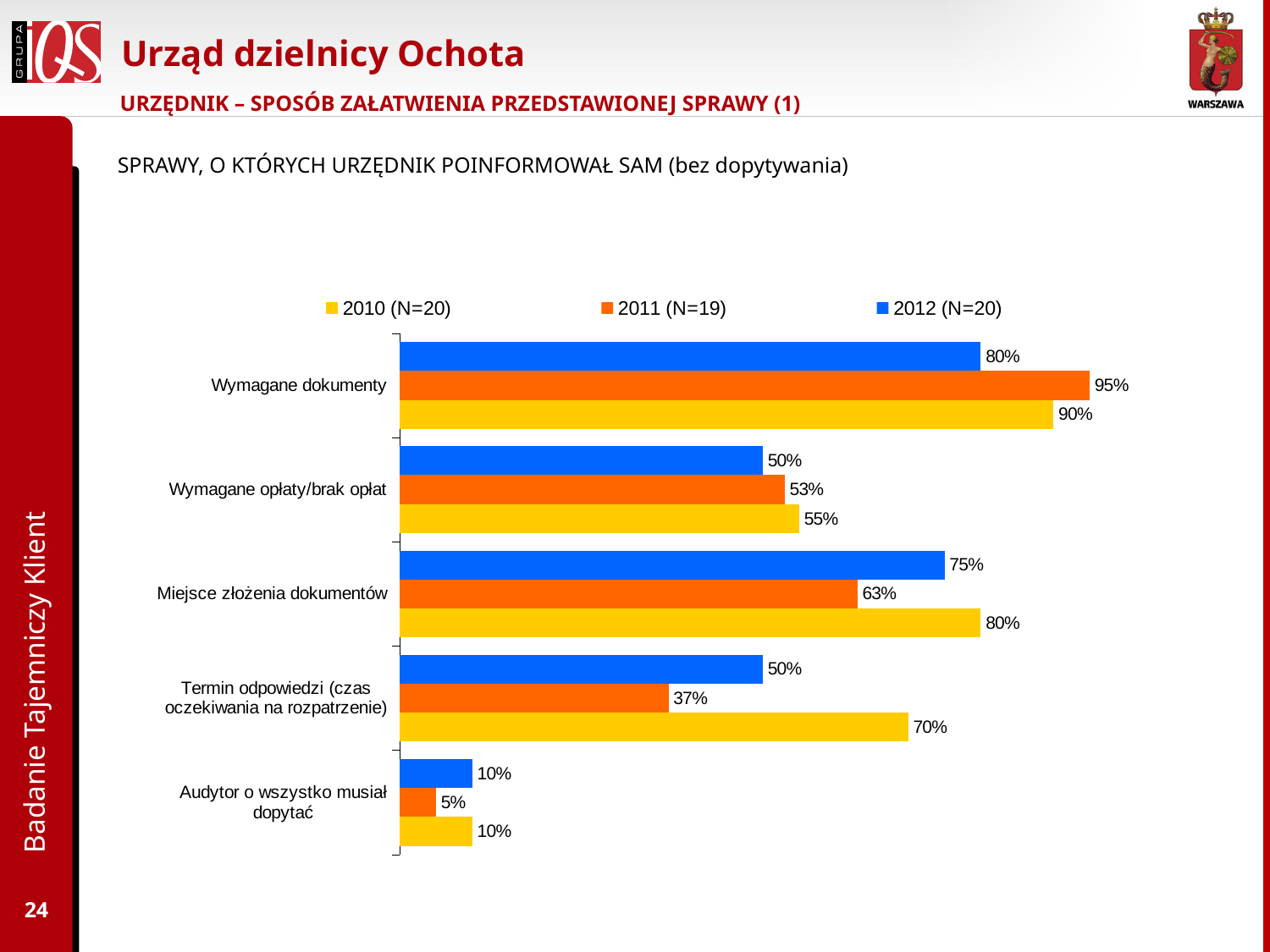
What is the value for Termin odpowiedzi (czas oczekiwania na rozpatrzenie) in the 2010 (N=20) series? 70% How many series does the legend list? 3 Which colour represents the 2012 (N=20) series in the legend? Blue What kind of chart is shown on the slide? Bar chart How many categories are shown on the chart? 5 What is the value for Miejsce złożenia dokumentów in the 2012 (N=20) series? 75% Which is larger for Miejsce złożenia dokumentów: the 2010 (N=20) value or the 2011 (N=19) value? 2010 (N=20) What is the value for Wymagane dokumenty in the 2011 (N=19) series? 95% Which category has the highest value in the 2012 (N=20) series? Wymagane dokumenty What is the value for Wymagane opłaty/brak opłat in the 2010 (N=20) series? 55% Which category has the lowest value in the 2011 (N=19) series? Audytor o wszystko musiał dopytać What is the difference between the 2010 (N=20) and 2011 (N=19) values for Termin odpowiedzi (czas oczekiwania na rozpatrzenie)? 33 percentage points